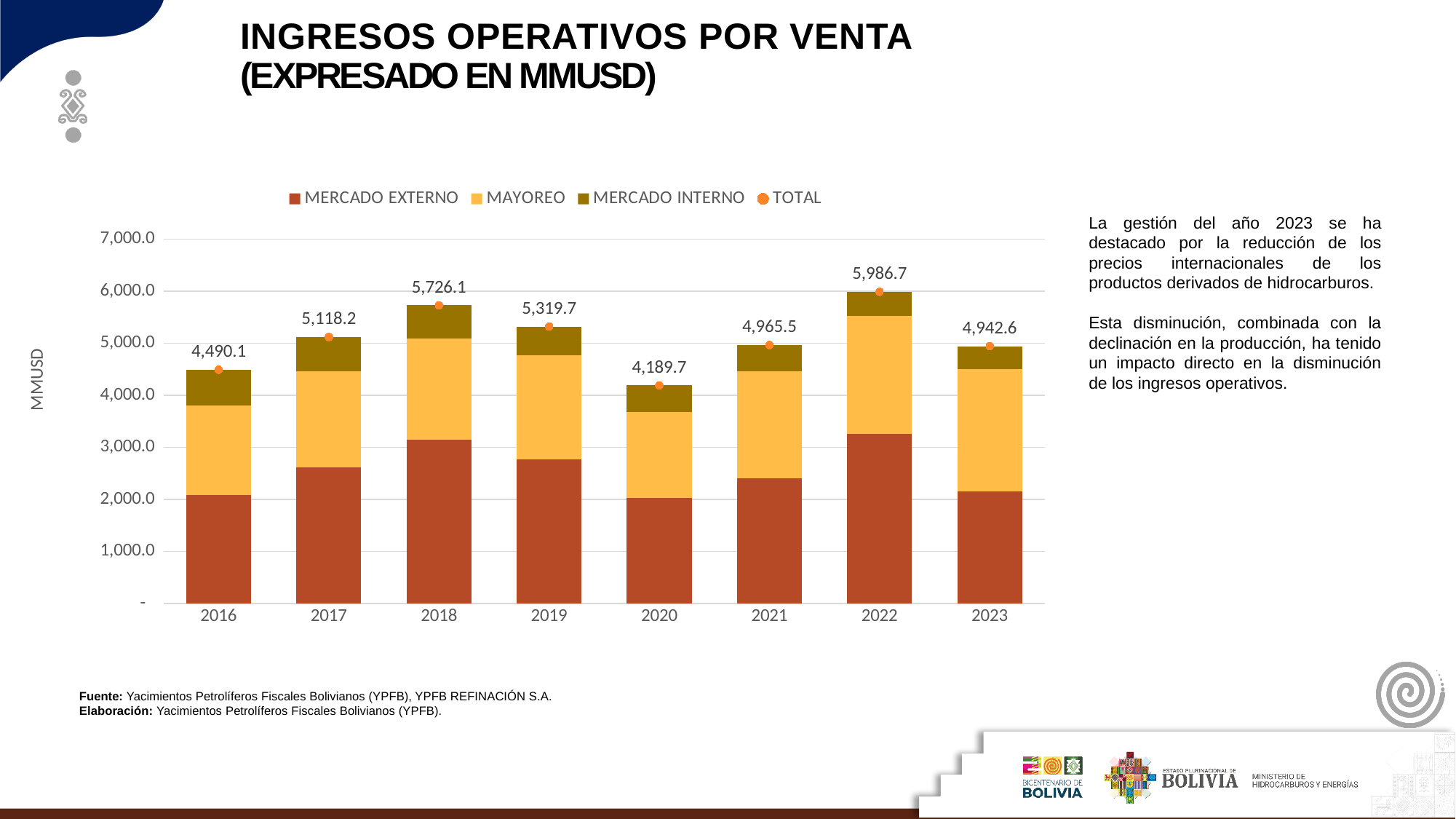
Is the MERCADO EXTERNO value for 2022 greater or less than 3,000.0? greater What is the difference between the TOTAL for 2022 and the TOTAL for 2023? 1,044.1 Which year has the highest TOTAL? 2022 What is the TOTAL value for 2020? 4,189.7 What kind of chart is shown on the slide? Stacked bar chart with a line of total markers What is the TOTAL value for 2023? 4,942.6 What is the TOTAL value for 2018? 5,726.1 How many series does the legend list? 4 Which is larger, the TOTAL for 2019 or the TOTAL for 2021? 2019 Which year has the lowest TOTAL? 2020 How many years are shown on the x axis? 8 What is the difference between the TOTAL for 2018 and the TOTAL for 2017? 607.9